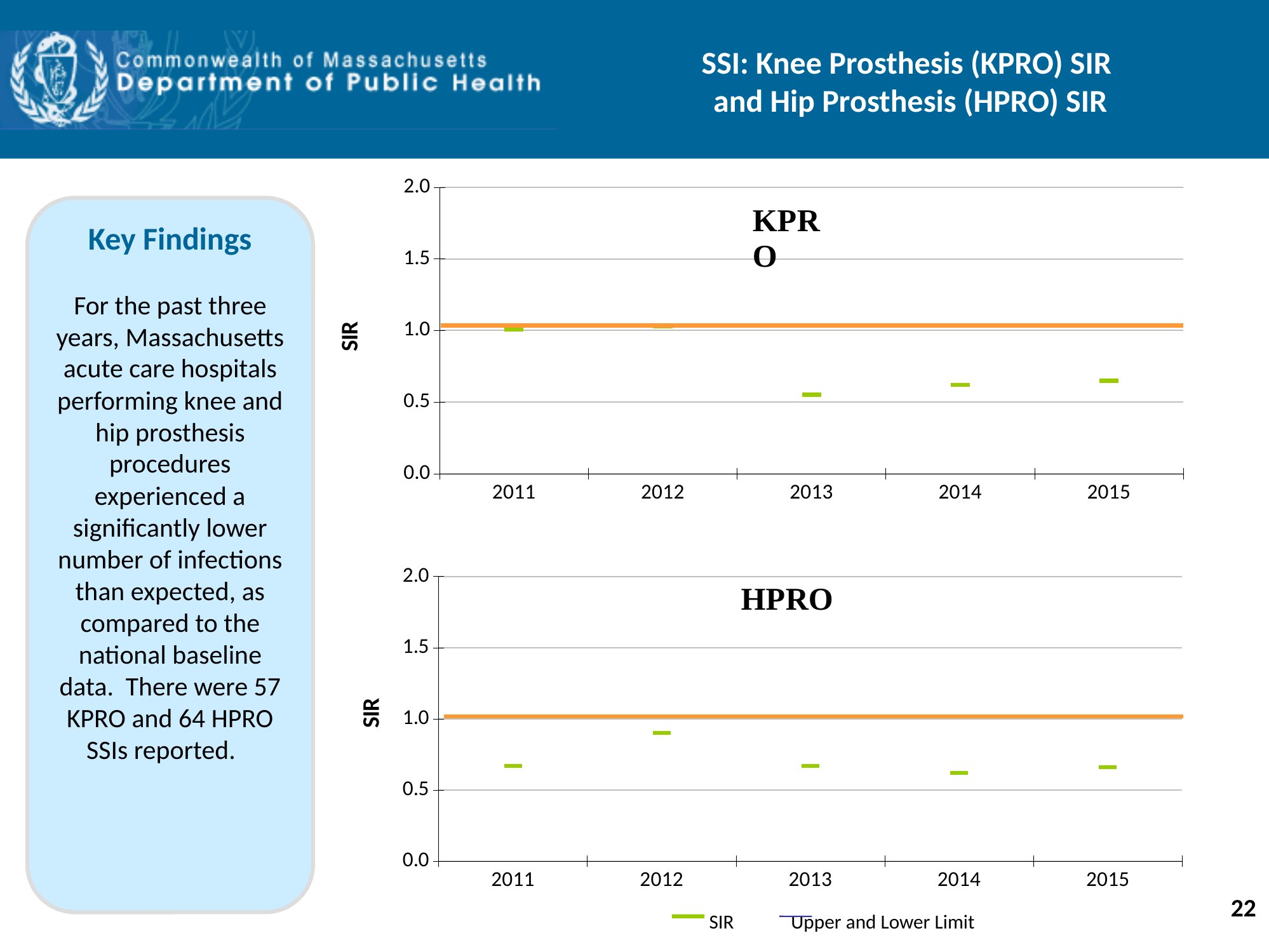
In the HPRO chart, which year has the highest SIR value? 2012 In the KPRO chart, which year has the lowest SIR value? 2013 What are the two entries listed in the legend below the charts? SIR; Upper and Lower Limit In the KPRO chart, which year has the larger SIR value, 2011 or 2013? 2011 In the KPRO chart, is the SIR value for 2013 greater or less than 1.0? less What is the label on the y axis of the HPRO chart? SIR In the HPRO chart, how many series does the legend list? 2 In the HPRO chart, is the SIR value for 2014 greater or less than 0.5? greater In the KPRO chart, how many years are shown on the x axis? 5 In the HPRO chart, is the SIR value for 2012 greater or less than 1.0? less In the HPRO chart, which year has the larger SIR value, 2012 or 2014? 2012